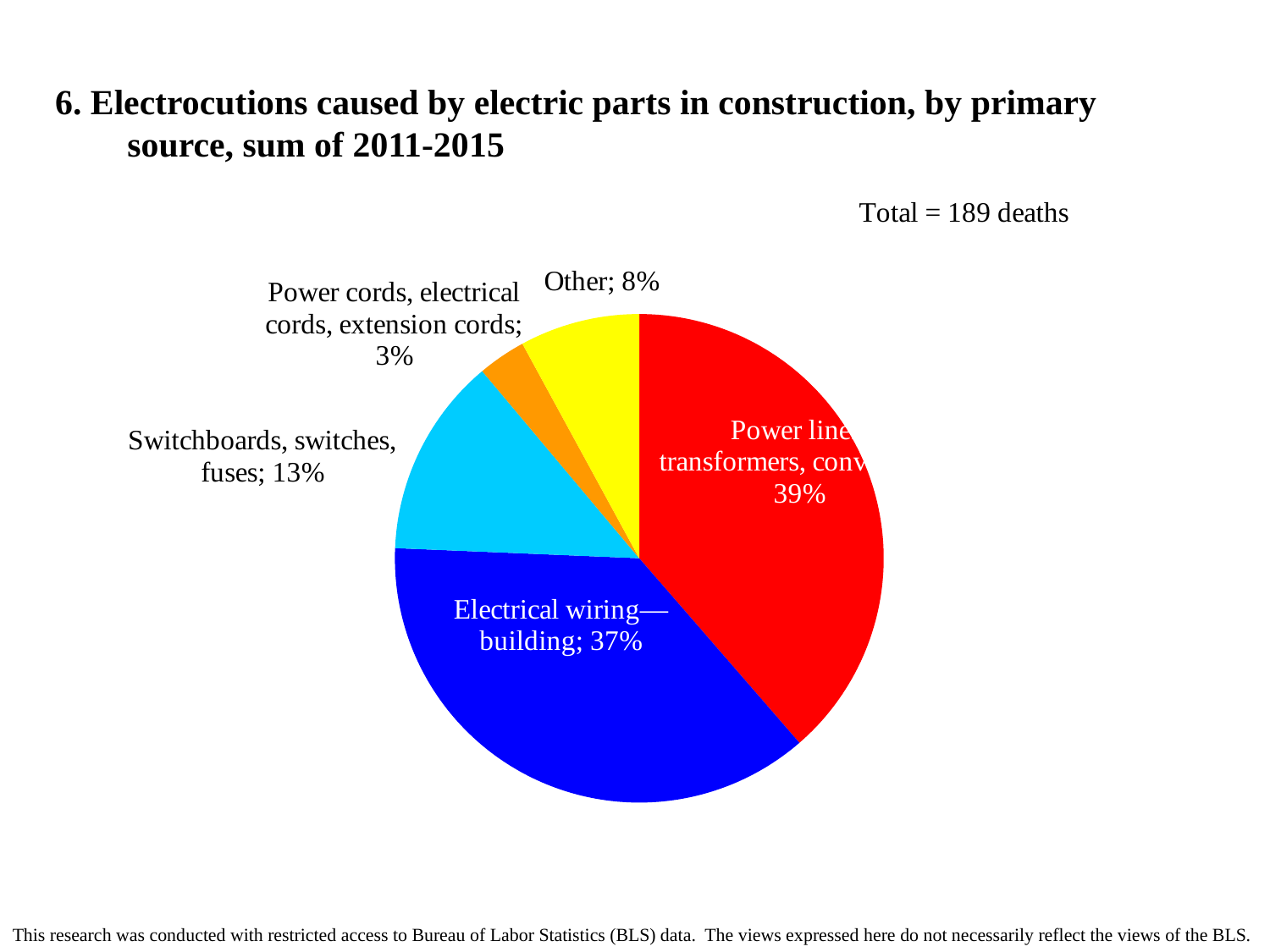
What percentage is shown for the Other slice? 8% Which slice of the pie is the smallest? Power cords, electrical cords, extension cords What percentage is shown for the red slice (Power line, transformers...)? 39% What kind of chart is shown on the slide? Pie chart What is the difference in percentage points between Electrical wiring—building and Switchboards, switches, fuses? 24 percentage points What percentage is shown for Switchboards, switches, fuses? 13% Which is larger, the Other slice or the Power cords, electrical cords, extension cords slice? Other Which slice of the pie is the largest? Power line, transformers (red slice), 39% What share of the pie does the Electrical wiring—building slice represent? 37% What total number of deaths does the slide state for the chart? 189 deaths What percentage is shown for Power cords, electrical cords, extension cords? 3% How many slices does the pie chart have? 5